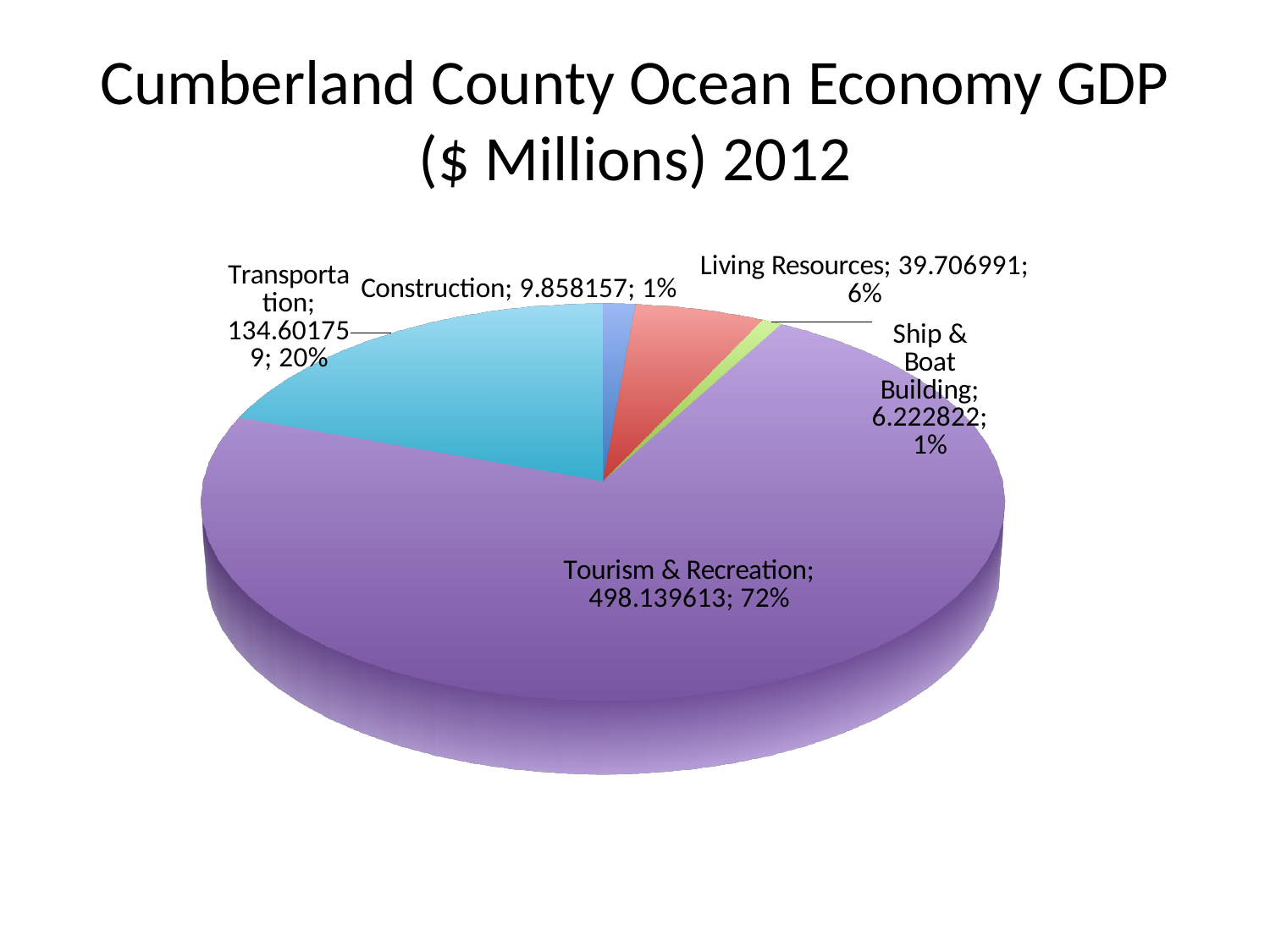
Which sector has the largest share of the pie? Tourism & Recreation What is the GDP value for Tourism & Recreation? 498.139613 Which sector has the smallest GDP value? Ship & Boat Building What percentage share of the pie does Living Resources have? 6% What is the GDP value for Transportation? 134.601759 What type of chart is shown on the slide? pie chart What is the GDP value for Living Resources? 39.706991 How many sectors are shown in the pie chart? 5 What is the difference between the GDP values for Tourism & Recreation and Transportation? 363.537854 What is the GDP value for Ship & Boat Building? 6.222822 Which has a larger GDP value, Construction or Ship & Boat Building? Construction What percentage share of the pie does Transportation have? 20%